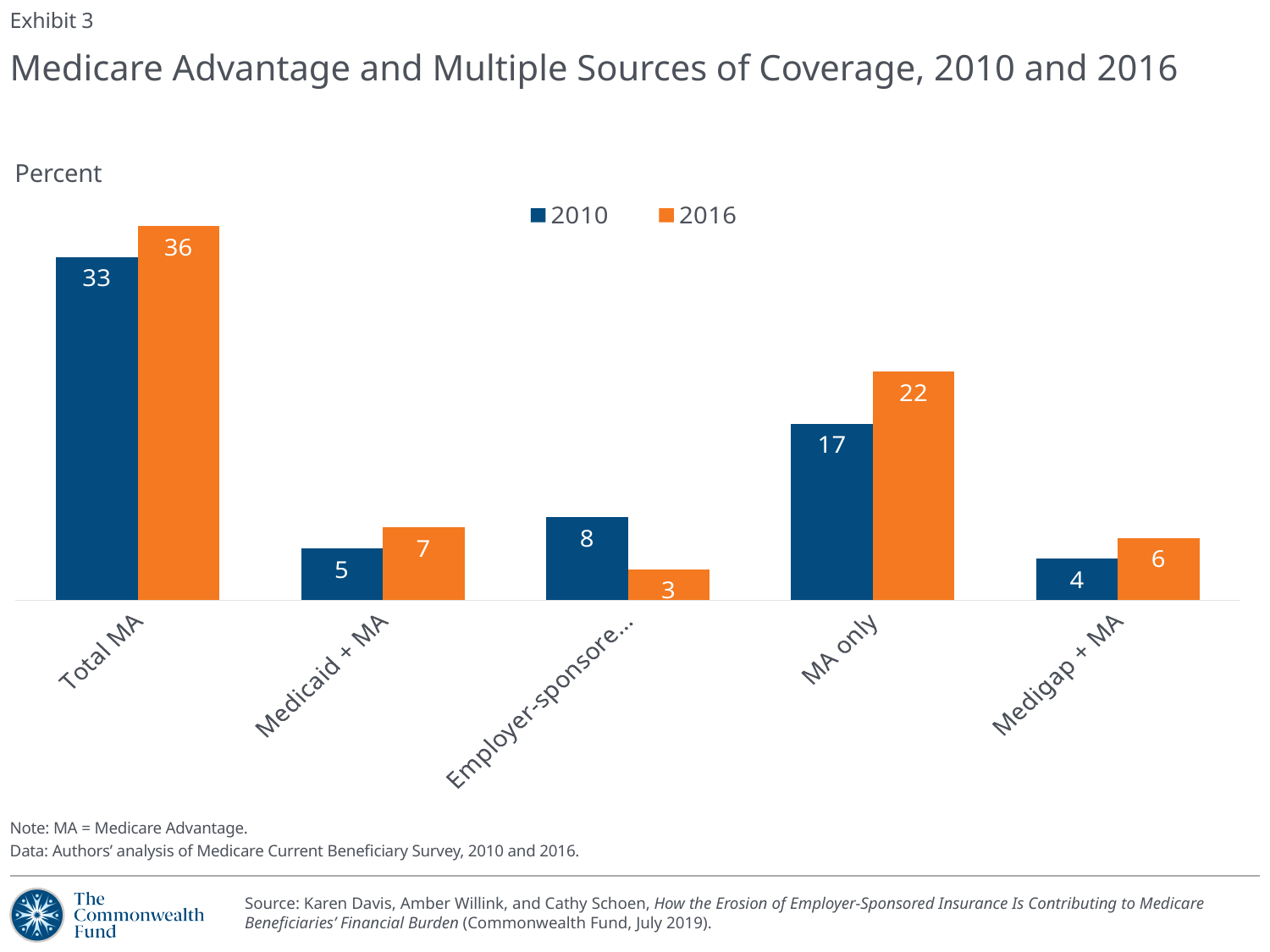
What was the value for Total MA in 2016? 36 How many categories are shown on the x axis? 5 What was the value for MA only in 2010? 17 Which category had the highest value in 2016? Total MA What type of chart is shown? Bar chart By how much did the value for MA only change from 2010 to 2016? 5 For Medigap + MA, which year had the larger value, 2010 or 2016? 2016 How many series does the legend list? 2 What is the difference between the 2010 and 2016 values for Total MA? 3 Which colour represents the 2016 series? Orange What was the value for Medicaid + MA in 2016? 7 Which category had the lowest value in 2010? Medigap + MA